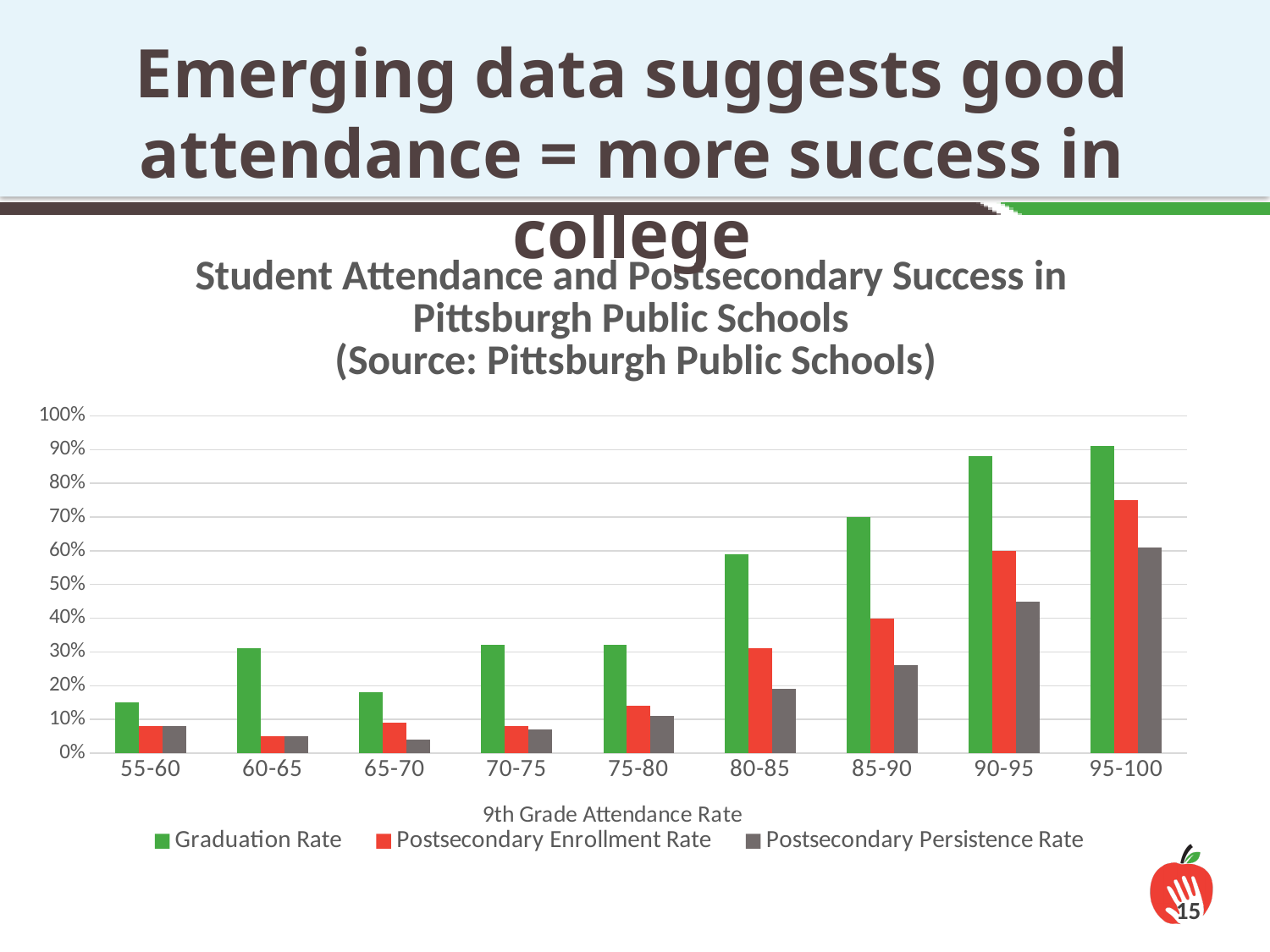
What is the title of the x axis? 9th Grade Attendance Rate Which attendance-rate category has the highest Graduation Rate? 95-100 Which has the larger Graduation Rate, the 75-80 category or the 80-85 category? 80-85 Is the Postsecondary Enrollment Rate for the 85-90 category greater or less than 50%? less How many attendance-rate categories are shown on the x axis? 9 Which attendance-rate category has the lowest Postsecondary Enrollment Rate? 60-65 Is the Graduation Rate for the 90-95 category greater or less than 80%? greater What kind of chart is shown on the slide? Bar chart For the 95-100 category, which is larger, the Postsecondary Enrollment Rate or the Postsecondary Persistence Rate? Postsecondary Enrollment Rate Does the Graduation Rate generally rise or fall as the 9th Grade Attendance Rate increases along the x axis? rise How many series does the legend list? 3 Is the Postsecondary Persistence Rate for the 80-85 category greater or less than 30%? less